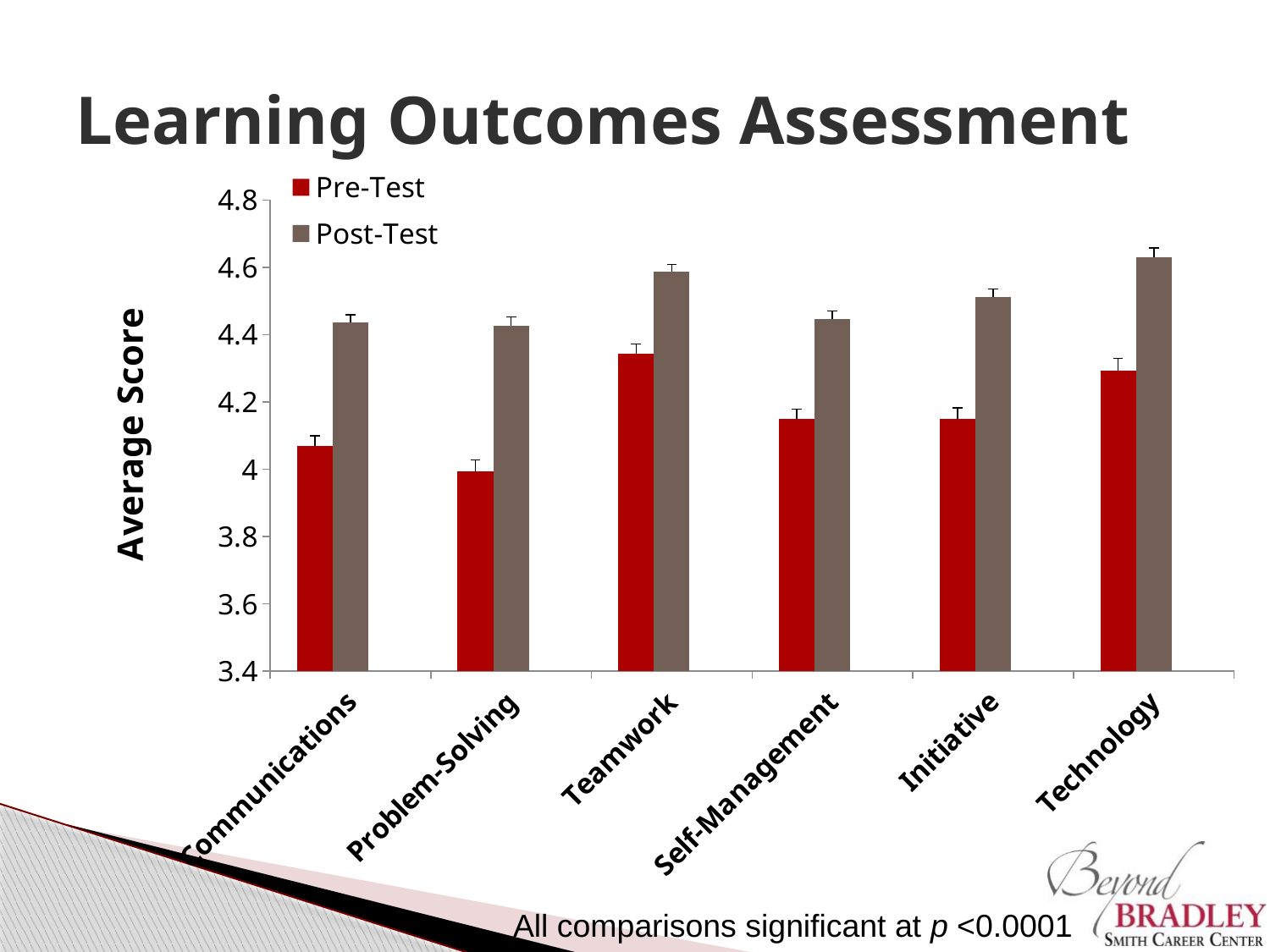
Which is larger: the Pre-Test score for Teamwork or the Pre-Test score for Communications? Teamwork For Initiative, which is larger: the Pre-Test or the Post-Test score? Post-Test How many series does the legend list? 2 What is the title of the y axis? Average Score What kind of chart is shown on the slide? bar chart Is the Pre-Test value for Self-Management greater or less than 4.2? less Which category has the highest Post-Test average score? Technology Is the Pre-Test value for Teamwork greater or less than 4.2? greater How many categories are shown on the x axis? 6 Which category has the lowest Pre-Test average score? Problem-Solving